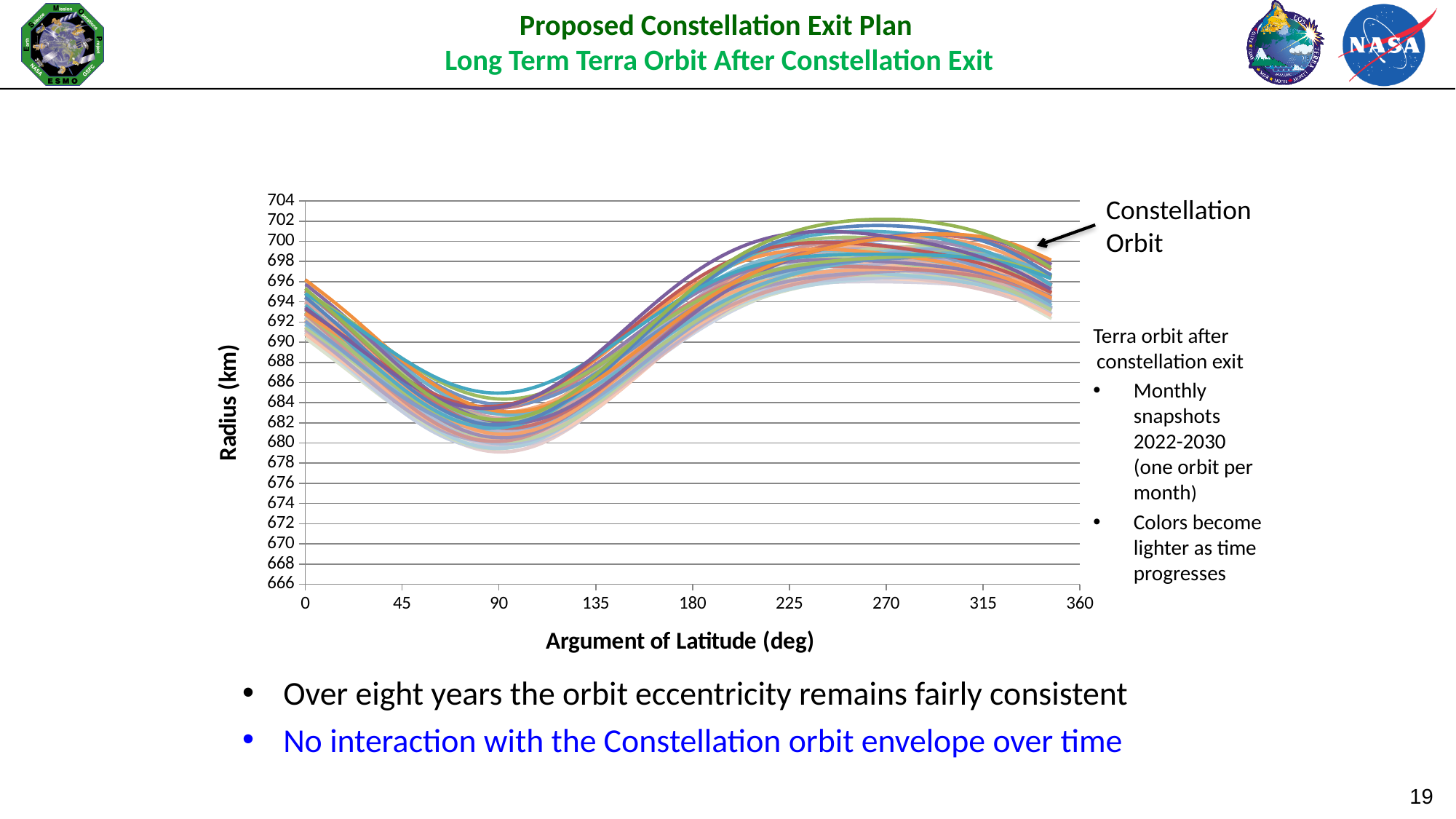
What is the title of the y axis of the chart? Radius (km) Is the radius at 180 degrees argument of latitude greater or less than the radius at 90 degrees? greater What kind of chart is shown on the slide? line chart At an argument of latitude of 90 degrees, are the plotted radius values greater or less than 690 km? less At an argument of latitude of 270 degrees, are the plotted radius values greater or less than 694 km? greater Do the plotted radius values rise or fall as the argument of latitude goes from 90 to 270 degrees? rise At an argument of latitude of 0 degrees, are the plotted radius values greater or less than 680 km? greater Around which x-axis tick value do the plotted curves reach their highest radius? 270 Around which x-axis tick value do the plotted curves reach their lowest radius? 90 Do the plotted radius values rise or fall as the argument of latitude goes from 0 to 90 degrees? fall How many tick labels are shown on the x axis of the chart? 9 What is the title of the x axis of the chart? Argument of Latitude (deg)